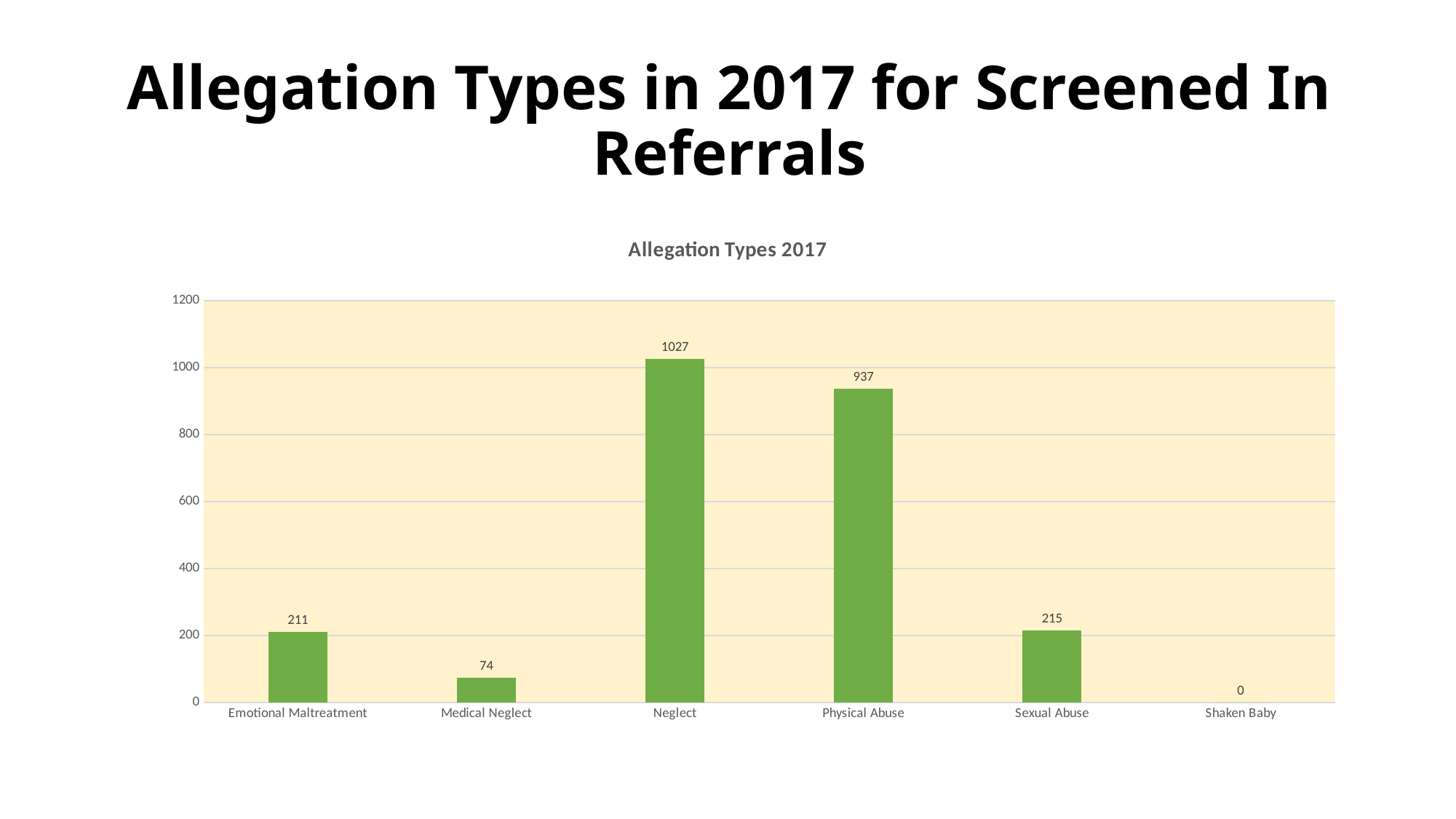
Which is larger, the value for Physical Abuse or the value for Emotional Maltreatment? Physical Abuse How many allegation types are shown on the x axis? 6 What is the value for Neglect? 1027 What kind of chart is shown on the slide? Bar chart What is the value for Medical Neglect? 74 What is the title of the chart? Allegation Types 2017 What is the difference between the values for Neglect and Physical Abuse? 90 What is the difference between the values for Sexual Abuse and Emotional Maltreatment? 4 What is the value for Sexual Abuse? 215 Which allegation type has the highest value? Neglect What is the value for Shaken Baby? 0 Which allegation type has the lowest value? Shaken Baby